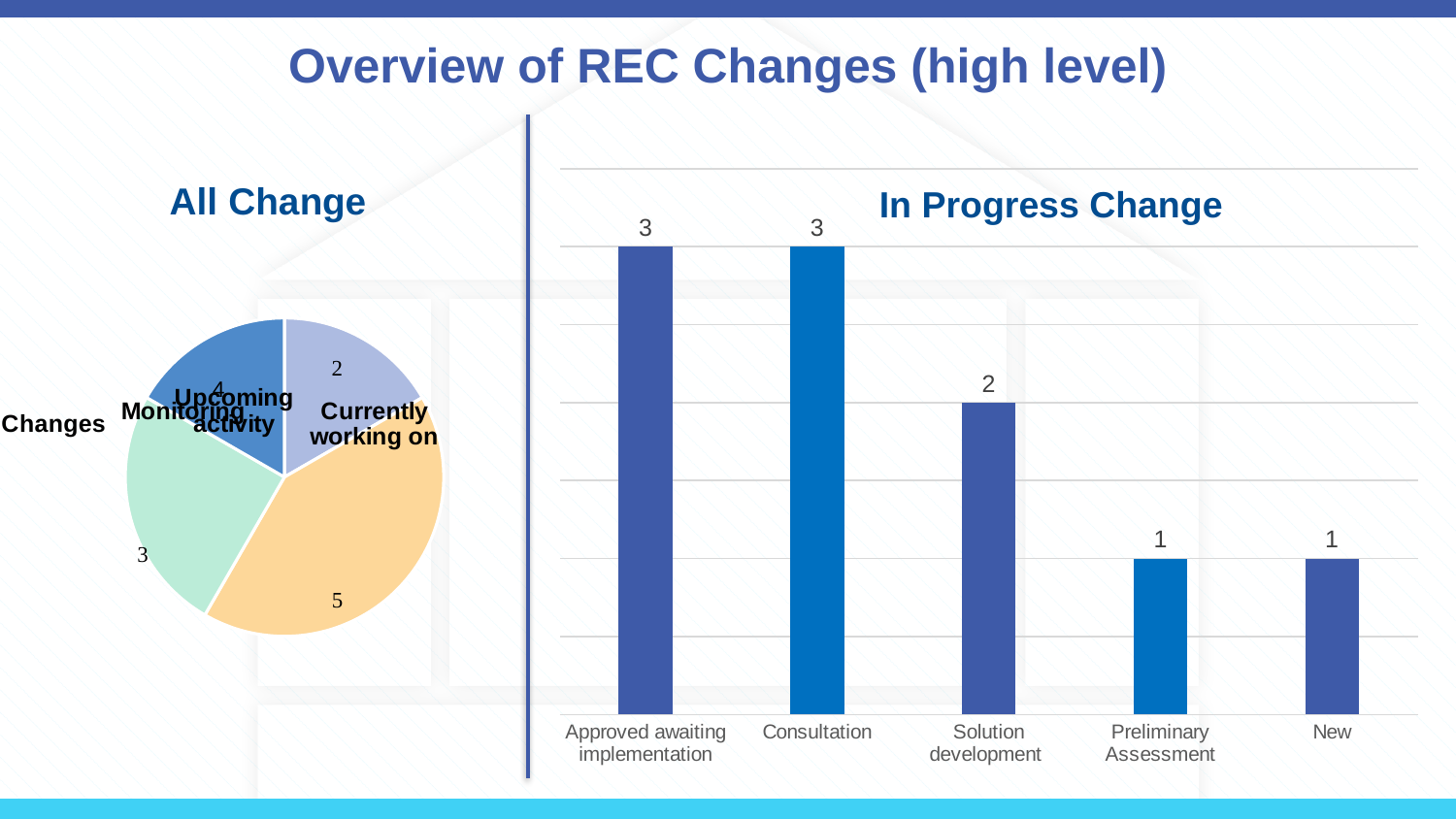
In the All Change pie chart, how many slices are there? 4 In the In Progress Change chart, what is the value for Solution development? 2 In the In Progress Change chart, what is the difference between Consultation and New? 2 In the In Progress Change chart, do the values rise or fall from left to right? Fall In the In Progress Change chart, what is the value for Consultation? 3 In the In Progress Change chart, what is the value for New? 1 In the In Progress Change chart, what is the value for Approved awaiting implementation? 3 What kind of chart is the In Progress Change chart? Bar chart In the In Progress Change chart, which is larger: Solution development or Preliminary Assessment? Solution development In the In Progress Change chart, how many categories are shown on the x axis? 5 What kind of chart is the All Change chart? Pie chart